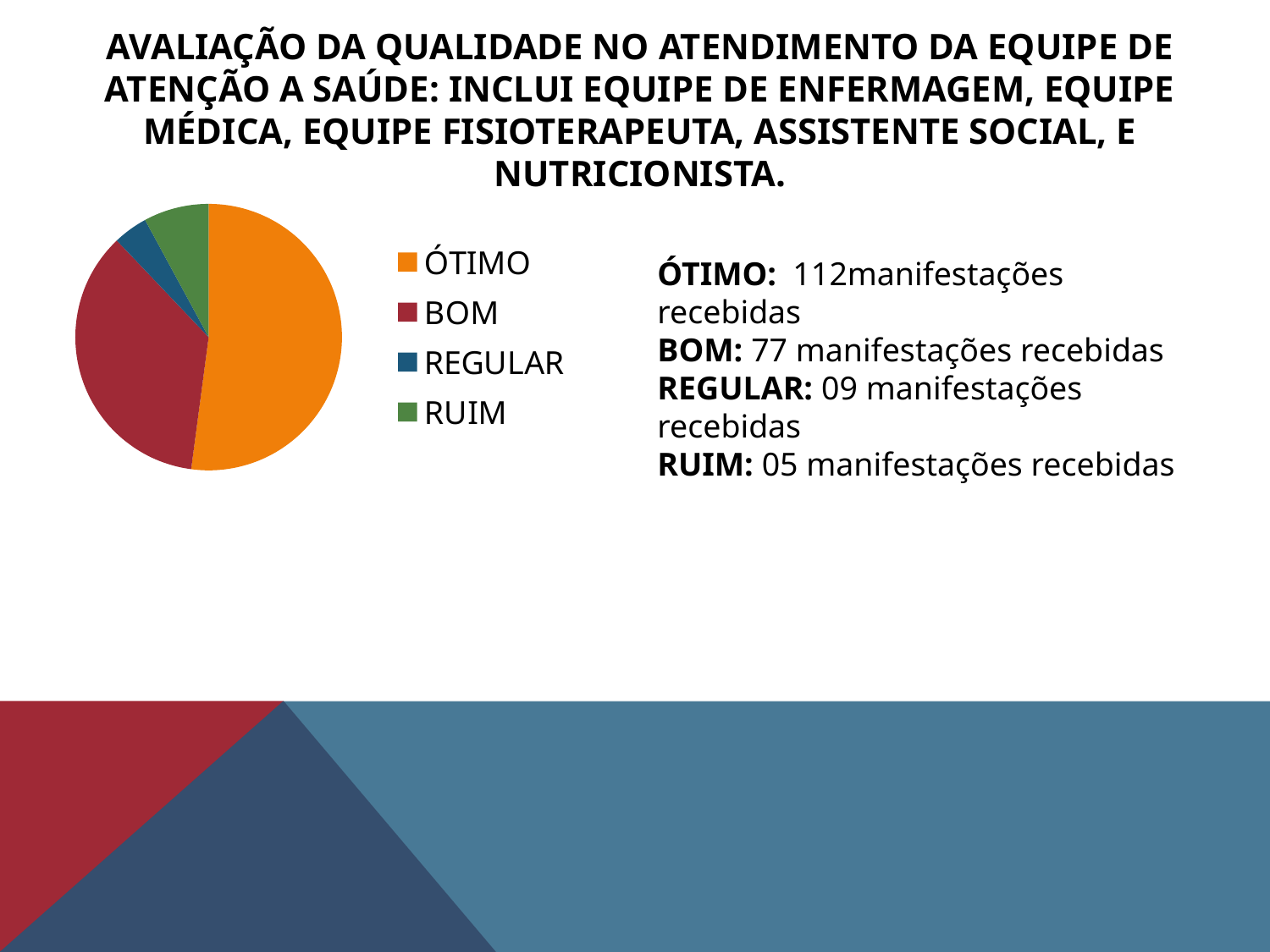
Which slice is larger in the pie chart, BOM or REGULAR? BOM What is the difference between the number of manifestações for ÓTIMO and for BOM? 35 Which category has the largest slice of the pie chart? ÓTIMO How many categories does the pie chart have? 4 How many manifestações recebidas are reported for REGULAR? 09 How many manifestações recebidas are reported for BOM? 77 How many manifestações recebidas are reported for RUIM? 05 How many manifestações recebidas are reported for ÓTIMO? 112 What colour is the ÓTIMO slice in the pie chart? orange What kind of chart is shown on the slide? pie chart How many entries does the legend of the pie chart list? 4 Which category has the smallest slice of the pie chart? REGULAR